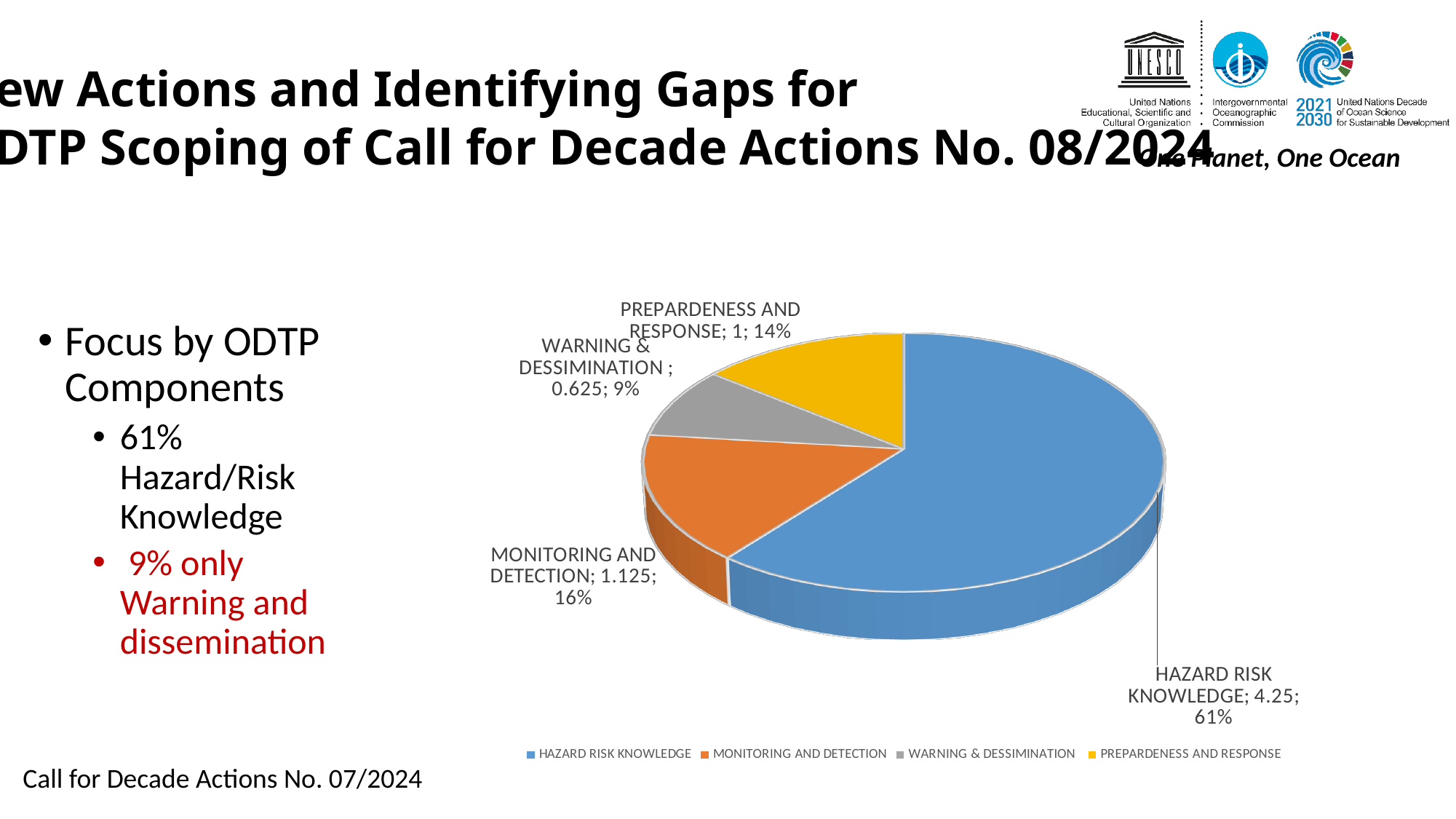
What is the difference between the values for HAZARD RISK KNOWLEDGE and MONITORING AND DETECTION? 3.125 What is the value for MONITORING AND DETECTION? 1.125 Which category has the largest slice? HAZARD RISK KNOWLEDGE What kind of chart is shown on the slide? pie chart What is the value for HAZARD RISK KNOWLEDGE? 4.25 What share of the pie does HAZARD RISK KNOWLEDGE represent? 61% What is the value for PREPARDENESS AND RESPONSE? 1 Which is larger, the value for MONITORING AND DETECTION or PREPARDENESS AND RESPONSE? MONITORING AND DETECTION What is the value for WARNING & DESSIMINATION? 0.625 Which category has the smallest slice? WARNING & DESSIMINATION What share of the pie does WARNING & DESSIMINATION represent? 9% How many categories does the pie chart show? 4